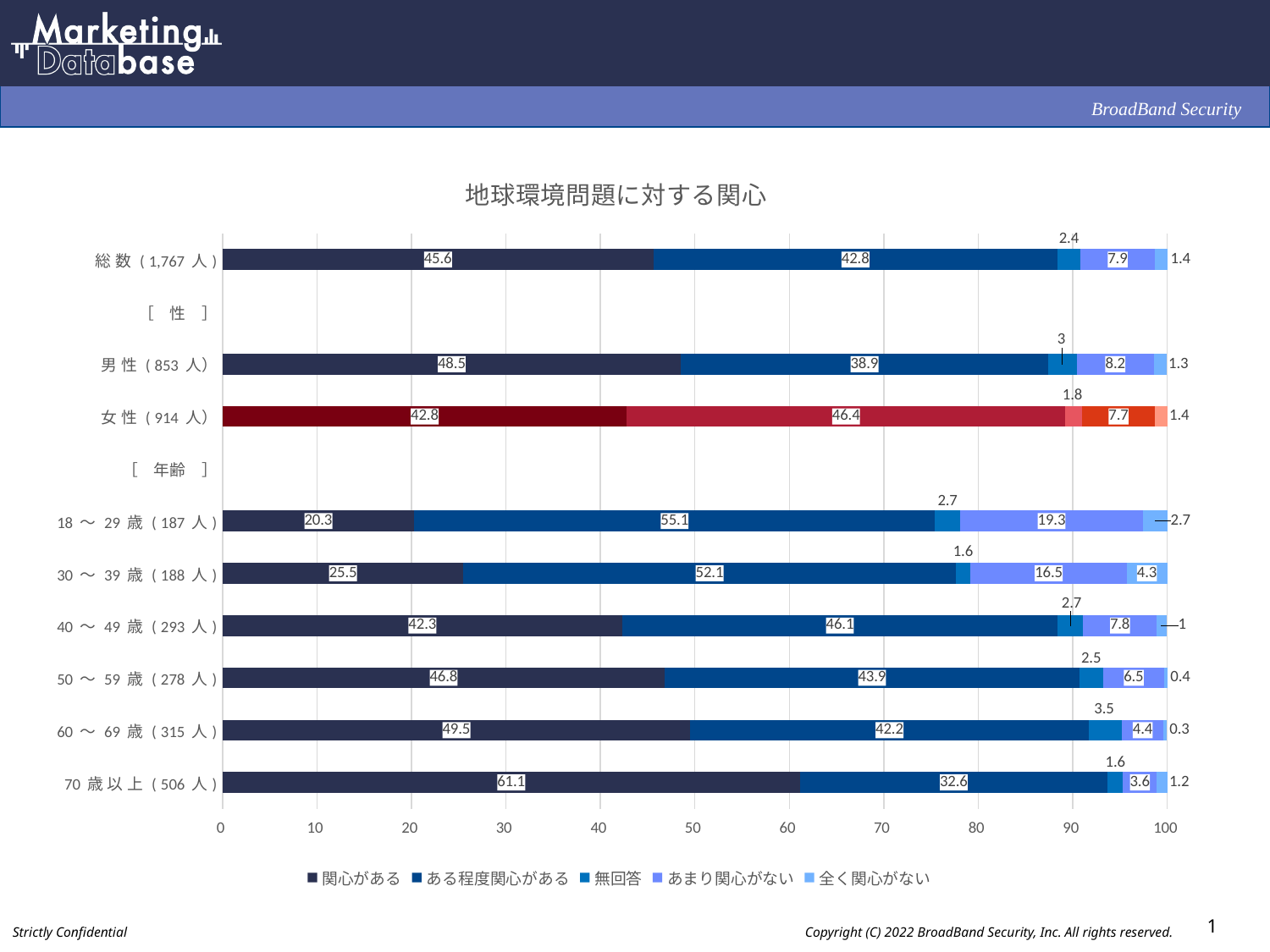
Which age group has the lowest value for 関心がある? 18〜29歳 (187人) What is the value of 関心がある for 総数 (1,767人)? 45.6 Which is larger for 50〜59歳 (278人): 関心がある or ある程度関心がある? 関心がある What is the value of ある程度関心がある for 女性 (914人)? 46.4 What is the combined value of 関心がある and ある程度関心がある for 70歳以上 (506人)? 93.7 What is the difference between the 関心がある values for 男性 (853人) and 女性 (914人)? 5.7 Which age group has the highest value for 関心がある? 70歳以上 (506人) What is the value of 全く関心がない for 30〜39歳 (188人)? 4.3 What is the title of the chart? 地球環境問題に対する関心 What is the value of あまり関心がない for 18〜29歳 (187人)? 19.3 How many series does the legend list? 5 What type of chart is shown on the slide? Stacked bar chart